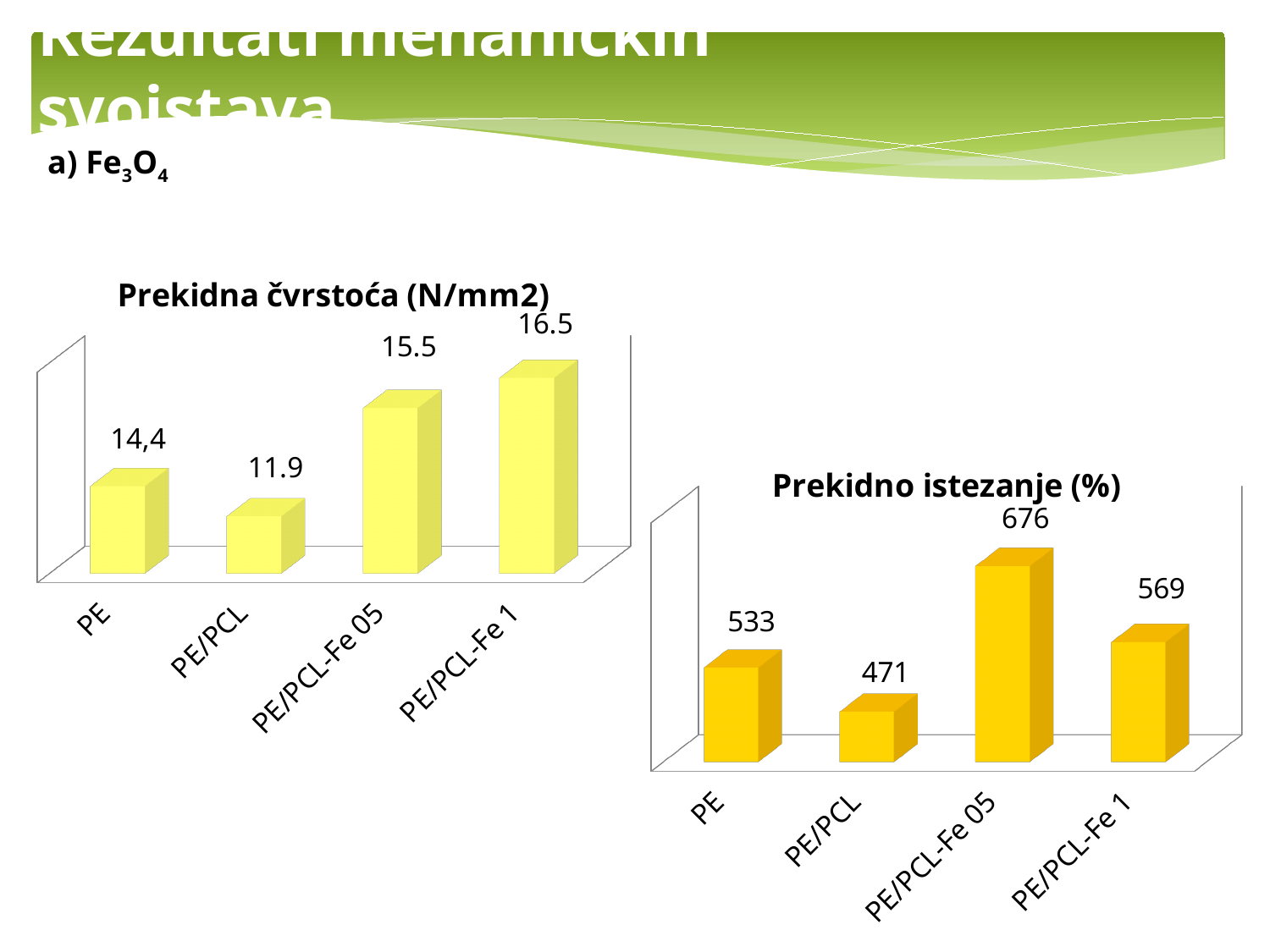
In the 'Prekidna čvrstoća (N/mm2)' chart, which category has the highest value? PE/PCL-Fe 1 In the 'Prekidno istezanje (%)' chart, which category has the highest value? PE/PCL-Fe 05 In the 'Prekidno istezanje (%)' chart, what is the value for PE? 533 In the 'Prekidno istezanje (%)' chart, what is the value for PE/PCL-Fe 05? 676 In the 'Prekidno istezanje (%)' chart, which category has the lowest value? PE/PCL In the 'Prekidno istezanje (%)' chart, what is the difference between PE/PCL-Fe 05 and PE/PCL? 205 In the 'Prekidna čvrstoća (N/mm2)' chart, what is the value for PE/PCL? 11.9 In the 'Prekidna čvrstoća (N/mm2)' chart, which category has the lowest value? PE/PCL In the 'Prekidna čvrstoća (N/mm2)' chart, what is the value for PE/PCL-Fe 1? 16.5 In the 'Prekidna čvrstoća (N/mm2)' chart, what is the difference between PE/PCL-Fe 1 and PE/PCL? 4.6 In the 'Prekidno istezanje (%)' chart, which is larger, PE or PE/PCL-Fe 1? PE/PCL-Fe 1 How many categories are shown in the 'Prekidna čvrstoća (N/mm2)' chart? 4